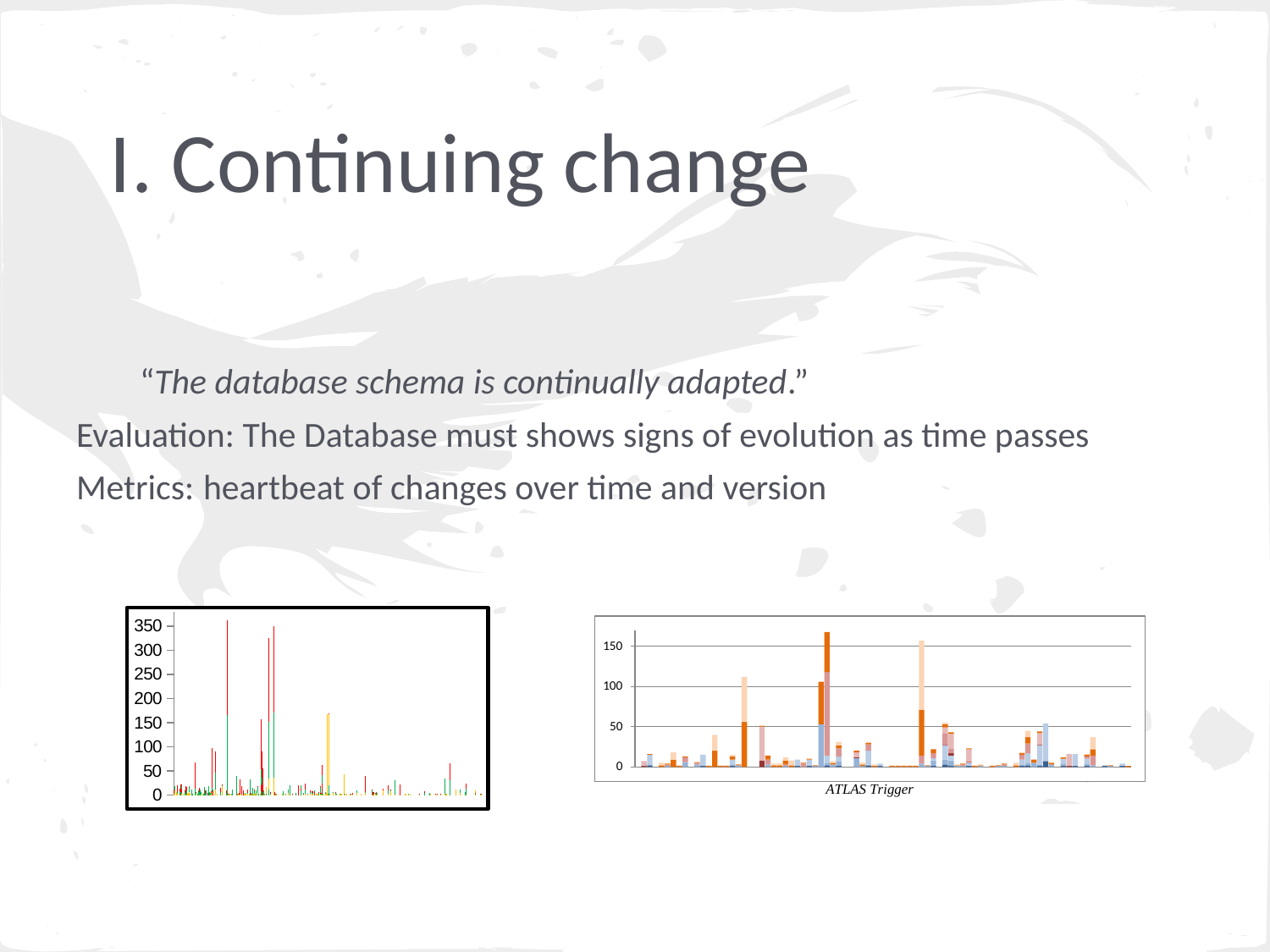
In the ATLAS Trigger chart, is the value of the tallest stacked bar greater or less than 150? greater What kind of chart is the chart on the left of the slide? bar chart In the chart on the left of the slide, is the value of the tallest bar greater or less than 300? greater What is the highest value labelled on the y axis of the ATLAS Trigger chart? 150 What is the highest value labelled on the y axis of the chart on the left of the slide? 350 What kind of chart is the chart on the right of the slide, captioned ATLAS Trigger? stacked bar chart What caption appears below the chart on the right of the slide? ATLAS Trigger In the chart on the left of the slide, is the value of the tallest green bar greater or less than 200? less